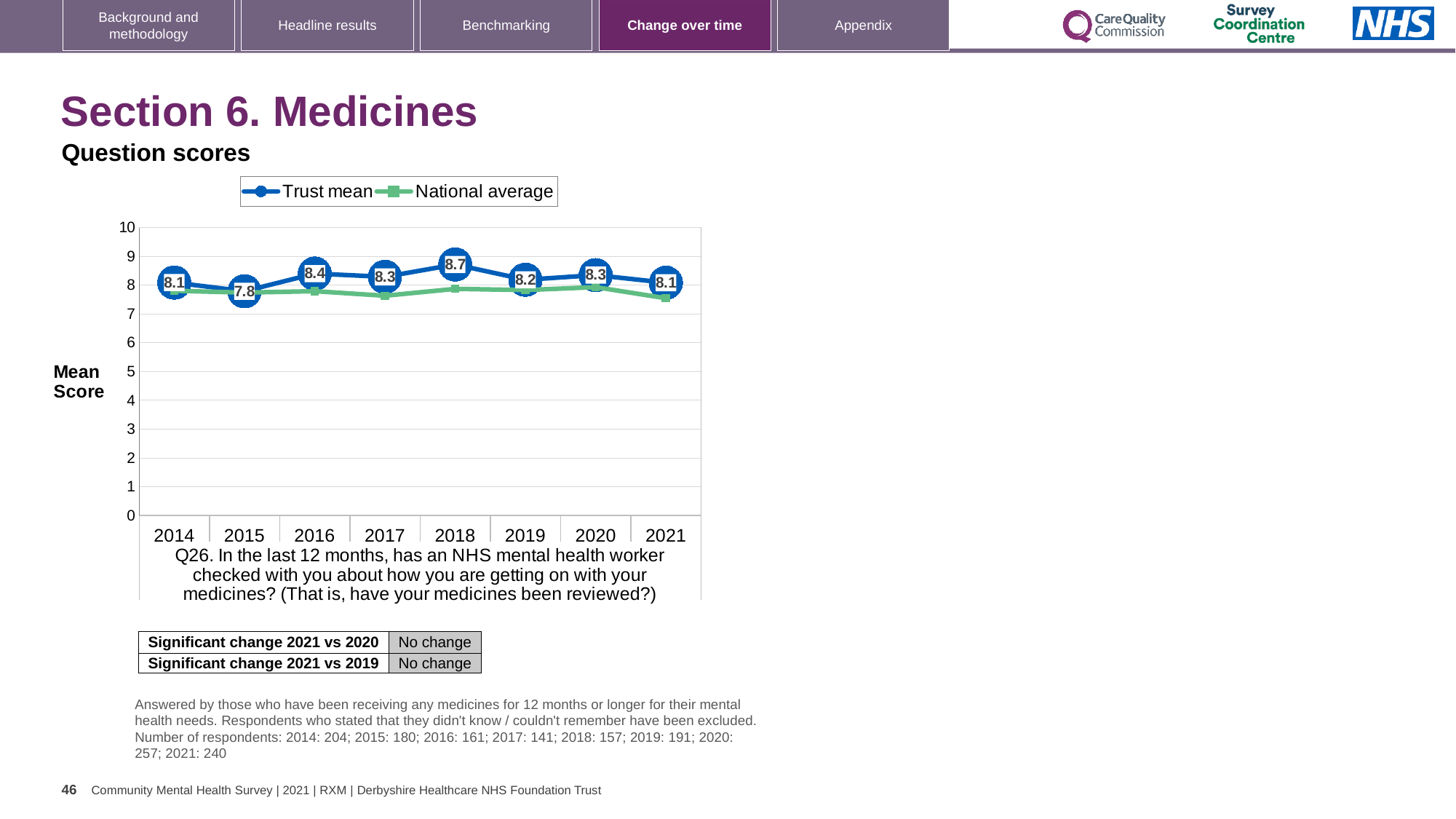
In which year is the Trust mean lowest? 2015 Which is larger, the Trust mean in 2016 or in 2019? 2016 How many series does the legend list? 2 What is the Trust mean score for 2015? 7.8 In which year is the Trust mean highest? 2018 Is the National average value for 2021 greater or less than 8? less What is the difference between the Trust mean in 2018 and in 2015? 0.9 What is the Trust mean score for 2021? 8.1 What is the Trust mean score for 2018? 8.7 What kind of chart is shown? line chart Does the Trust mean rise or fall from 2020 to 2021? fall How many years are shown on the x axis? 8